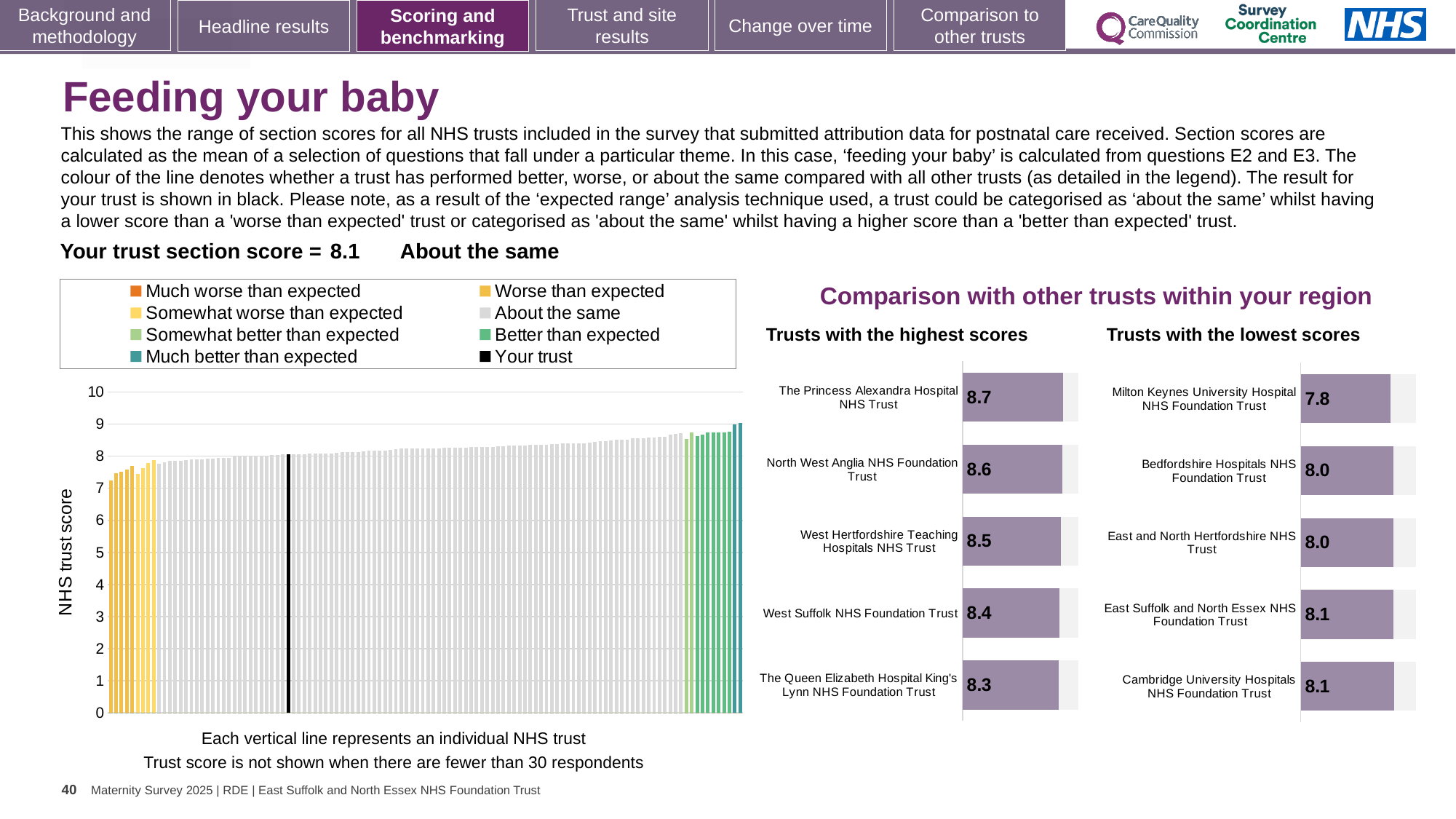
How many entries does the legend of the NHS trust score chart list? 8 How many trusts are shown in the 'Trusts with the highest scores' chart? 5 In the 'Trusts with the lowest scores' chart, what is the score for Milton Keynes University Hospital NHS Foundation Trust? 7.8 In the 'Trusts with the highest scores' chart, what is the difference between the scores of The Princess Alexandra Hospital NHS Trust and The Queen Elizabeth Hospital King's Lynn NHS Foundation Trust? 0.4 In the 'Trusts with the lowest scores' chart, which has the higher score: Milton Keynes University Hospital NHS Foundation Trust or Bedfordshire Hospitals NHS Foundation Trust? Bedfordshire Hospitals NHS Foundation Trust What kind of chart is the NHS trust score chart on the left? Bar chart In the 'Trusts with the highest scores' chart, which trust has the lowest score? The Queen Elizabeth Hospital King's Lynn NHS Foundation Trust In the 'Trusts with the highest scores' chart, what is the score for The Princess Alexandra Hospital NHS Trust? 8.7 In the 'Trusts with the lowest scores' chart, what is the score for Cambridge University Hospitals NHS Foundation Trust? 8.1 In the NHS trust score chart on the left, do the values rise or fall from left to right along the x axis? Rise In the 'Trusts with the highest scores' chart, what is the score for West Suffolk NHS Foundation Trust? 8.4 In the 'Trusts with the lowest scores' chart, which trust has the lowest score? Milton Keynes University Hospital NHS Foundation Trust